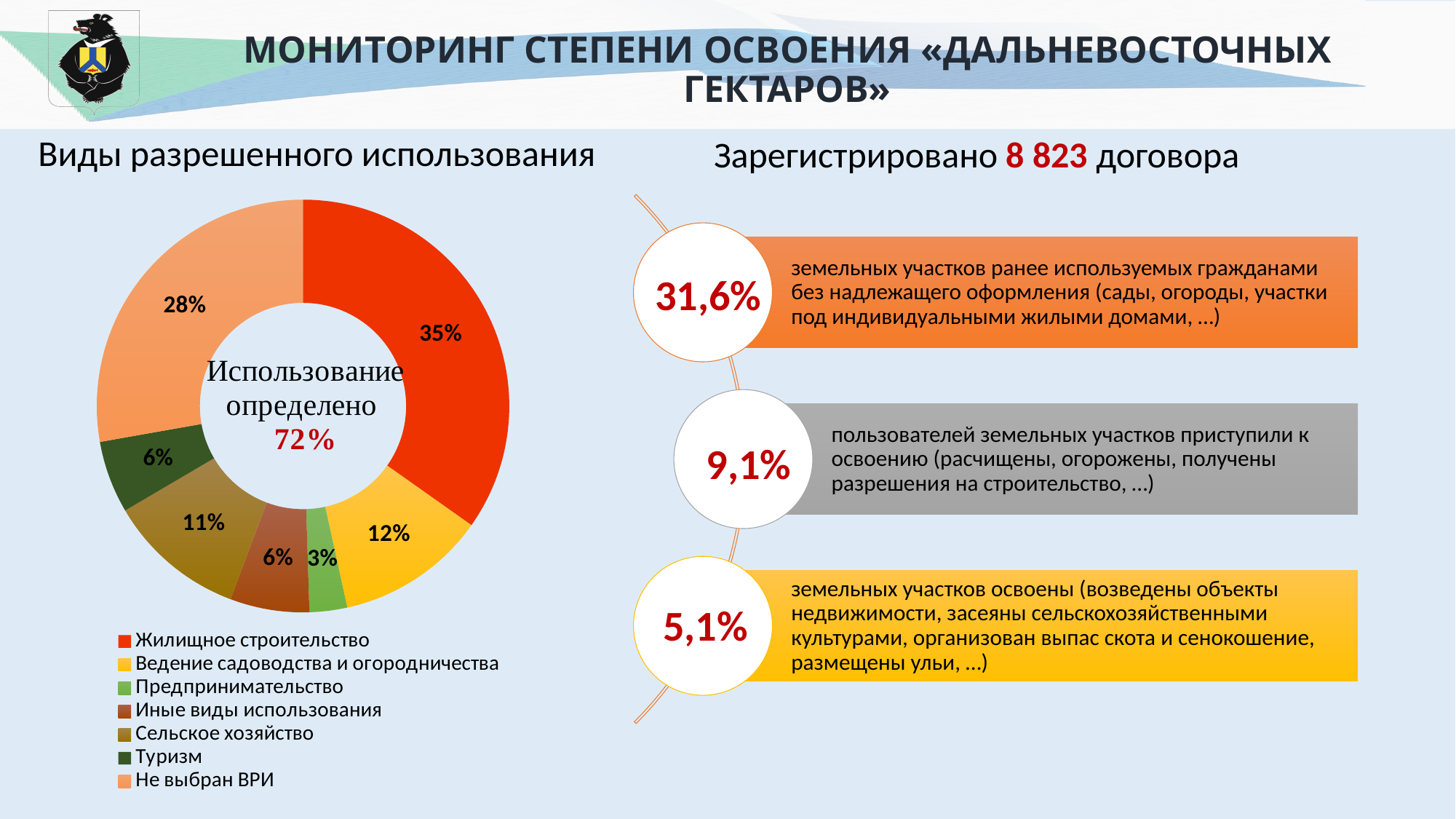
What is the value shown for Сельское хозяйство in the chart? 11% What share of the doughnut chart is labelled Не выбран ВРИ? 28% How many categories are shown in the doughnut chart's legend? 7 What is the title above the doughnut chart? Виды разрешенного использования Which category has the largest slice in the doughnut chart? Жилищное строительство Which category has the smallest slice in the doughnut chart? Предпринимательство What percentage does the Жилищное строительство slice represent in the doughnut chart? 35% Which is larger: the slice for Сельское хозяйство or the slice for Ведение садоводства и огородничества? Ведение садоводства и огородничества What percentage is shown for Ведение садоводства и огородничества? 12% What percentage is printed in the centre of the doughnut chart next to 'Использование определено'? 72% What type of chart is used to show the types of permitted use? Doughnut (pie) chart By how many percentage points does Жилищное строительство exceed Ведение садоводства и огородничества? 23 percentage points